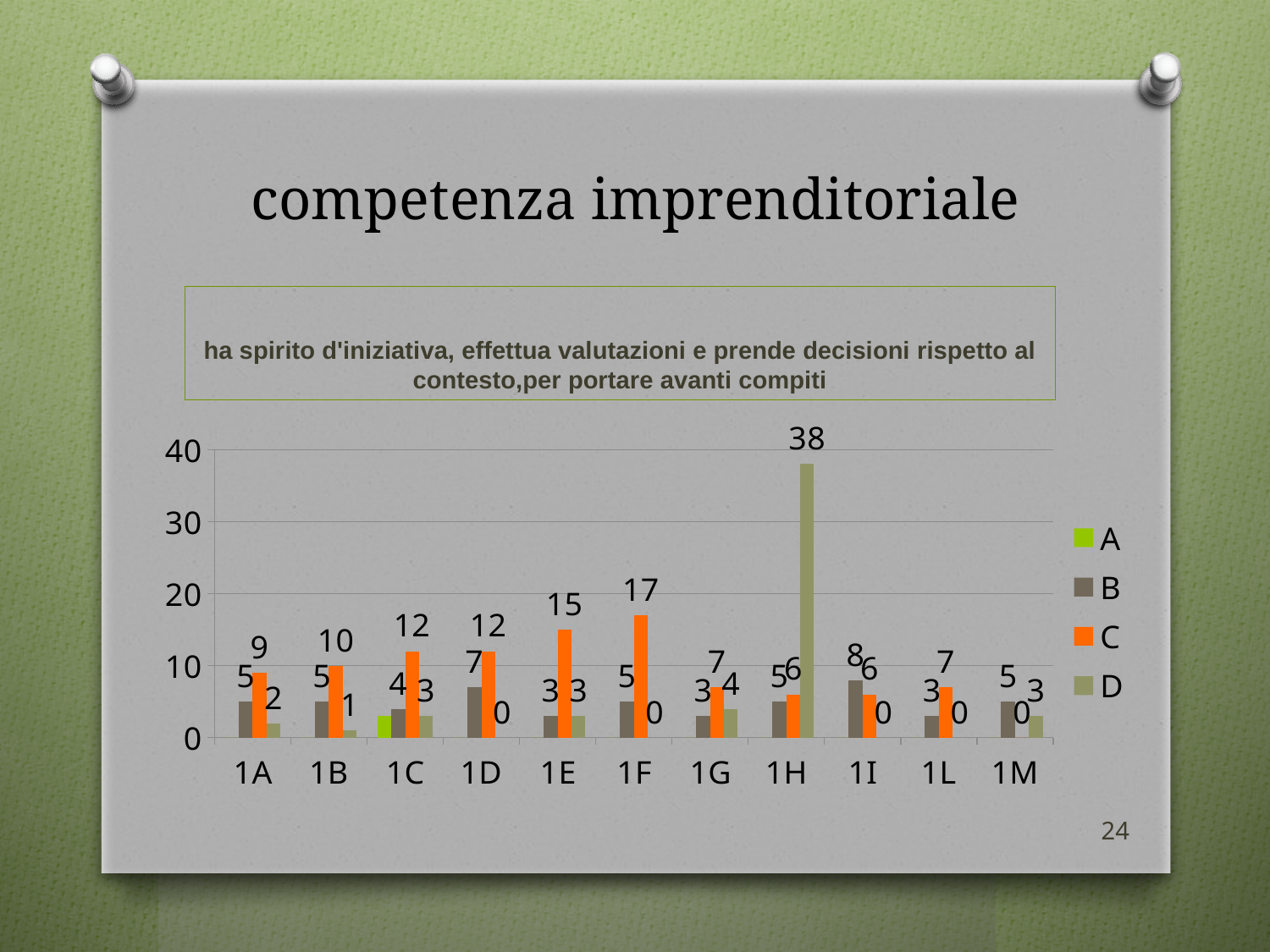
What is the difference between the series C values for 1F and 1E? 2 What is the value of series B for category 1I? 8 What is the value of series C for category 1M? 0 What is the title of the slide containing the chart? competenza imprenditoriale How many series does the chart legend list? 4 Is the value of series D for category 1H greater or less than 30? greater What is the value of series C for category 1F? 17 Which is larger: the series B value for 1I or the series B value for 1D? 1I How many categories are shown on the x axis of the chart? 11 Which category has the highest value for series C? 1F What kind of chart is shown on the slide? bar chart What is the value of series D for category 1H? 38